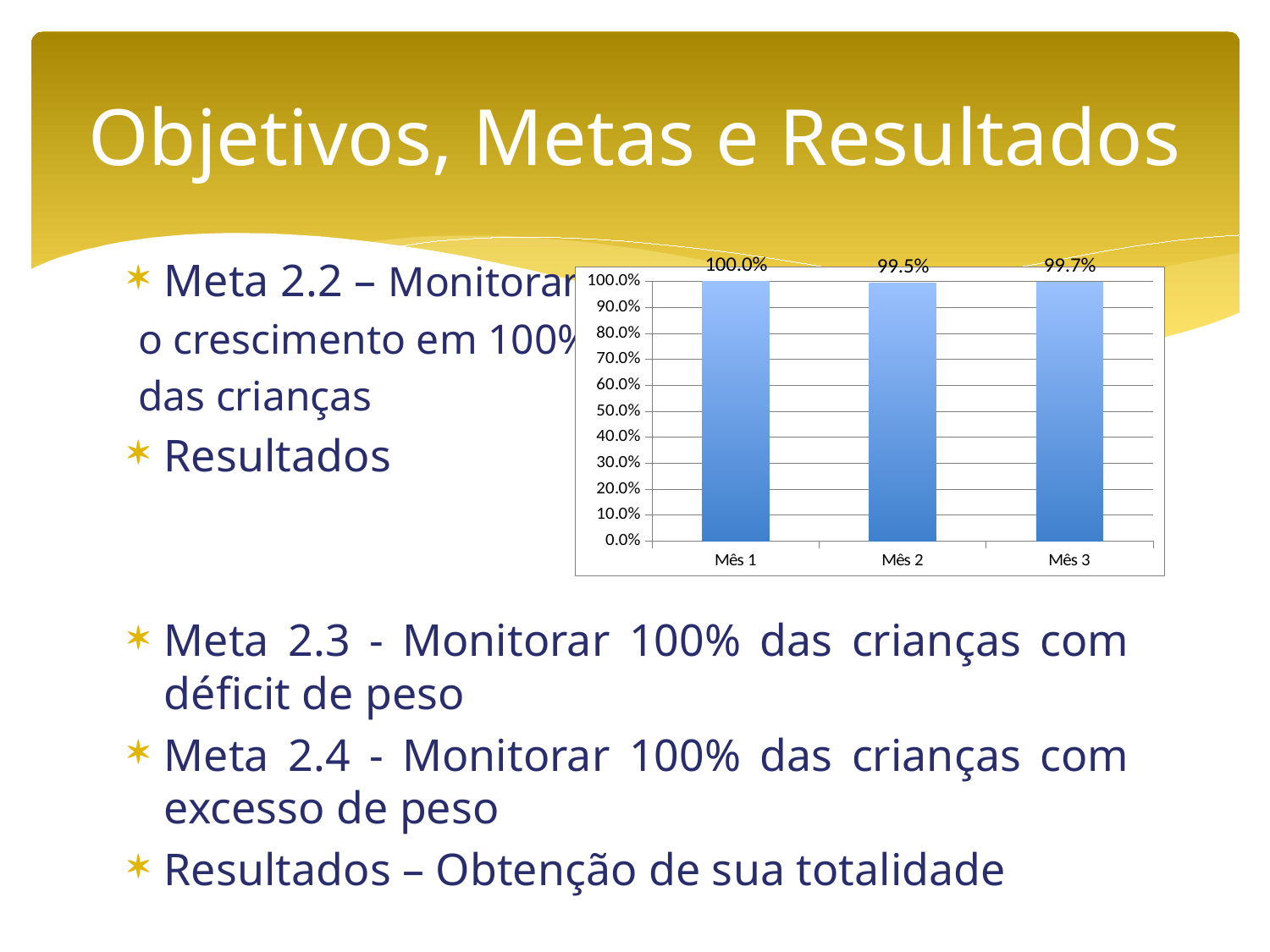
How many categories are shown on the x axis? 3 What is the highest tick value shown on the y axis? 100.0% What is the value for Mês 2? 99.5% What is the label of the first category on the x axis? Mês 1 What is the difference between the values for Mês 1 and Mês 2? 0.5% What is the difference between the values for Mês 3 and Mês 2? 0.2% What is the value for Mês 3? 99.7% Is the value for Mês 2 greater or less than 90.0%? greater Which month has the highest value? Mês 1 What kind of chart is shown on the slide? Bar chart What is the value for Mês 1? 100.0% Which month has the lowest value? Mês 2